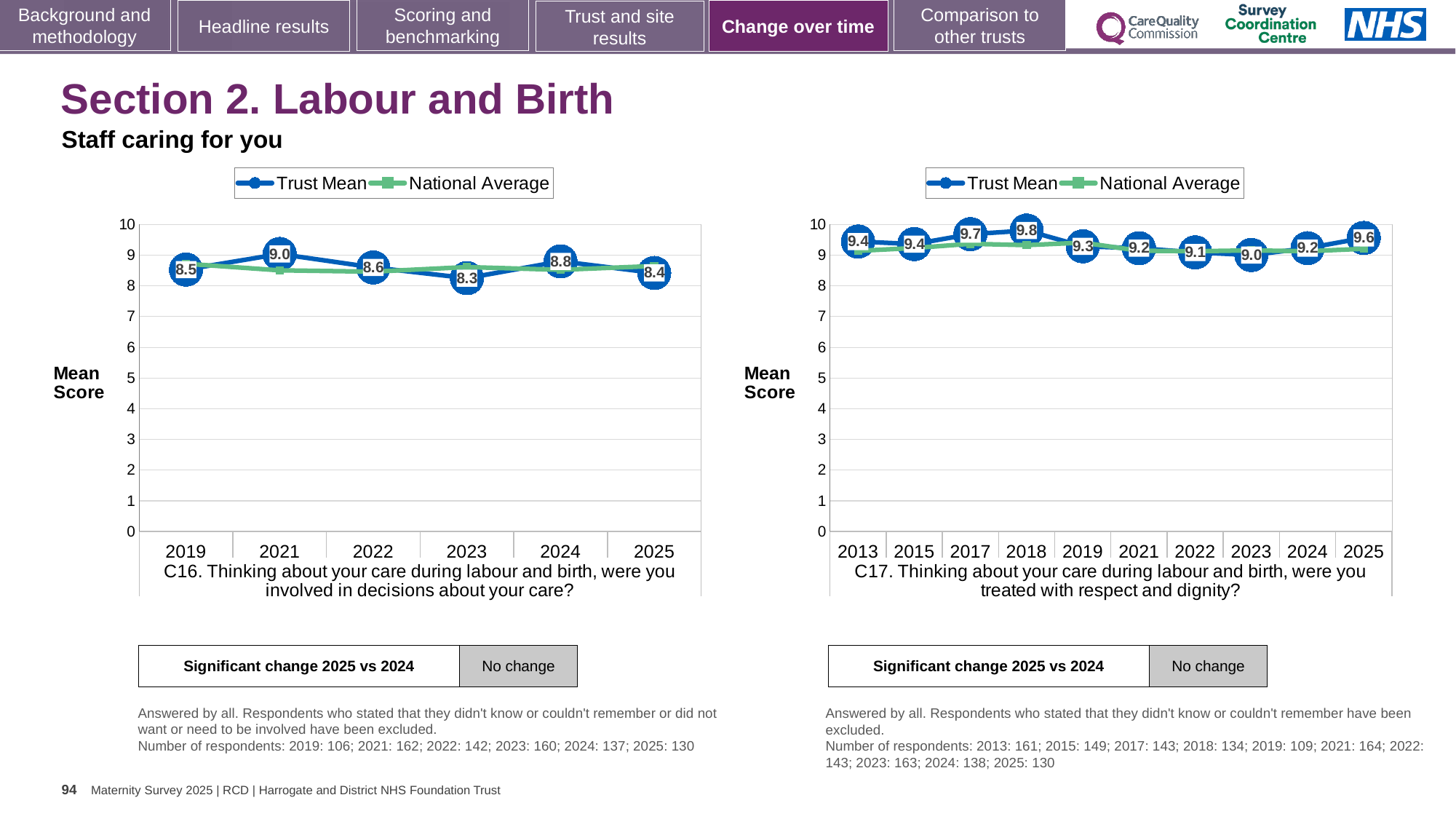
In the C16 chart (left), what is the Trust Mean score for 2021? 9.0 In the C16 chart (left), which year has the highest Trust Mean score? 2021 In the C17 chart (right), which year has the lowest Trust Mean score? 2023 In the C16 chart (left), what is the Trust Mean score for 2025? 8.4 In the C17 chart (right), how many years are shown on the x axis? 10 In the C17 chart (right), what is the Trust Mean score for 2018? 9.8 In the C16 chart (left), what is the difference between the Trust Mean scores for 2024 and 2023? 0.5 In the C16 chart (left), how many years are shown on the x axis? 6 In the C16 chart (left), which year has the lowest Trust Mean score? 2023 What type of chart is the C16 chart (left)? line chart How many series does the legend of the C17 chart (right) list? 2 In the C17 chart (right), is the Trust Mean score for 2025 higher or lower than for 2024? higher